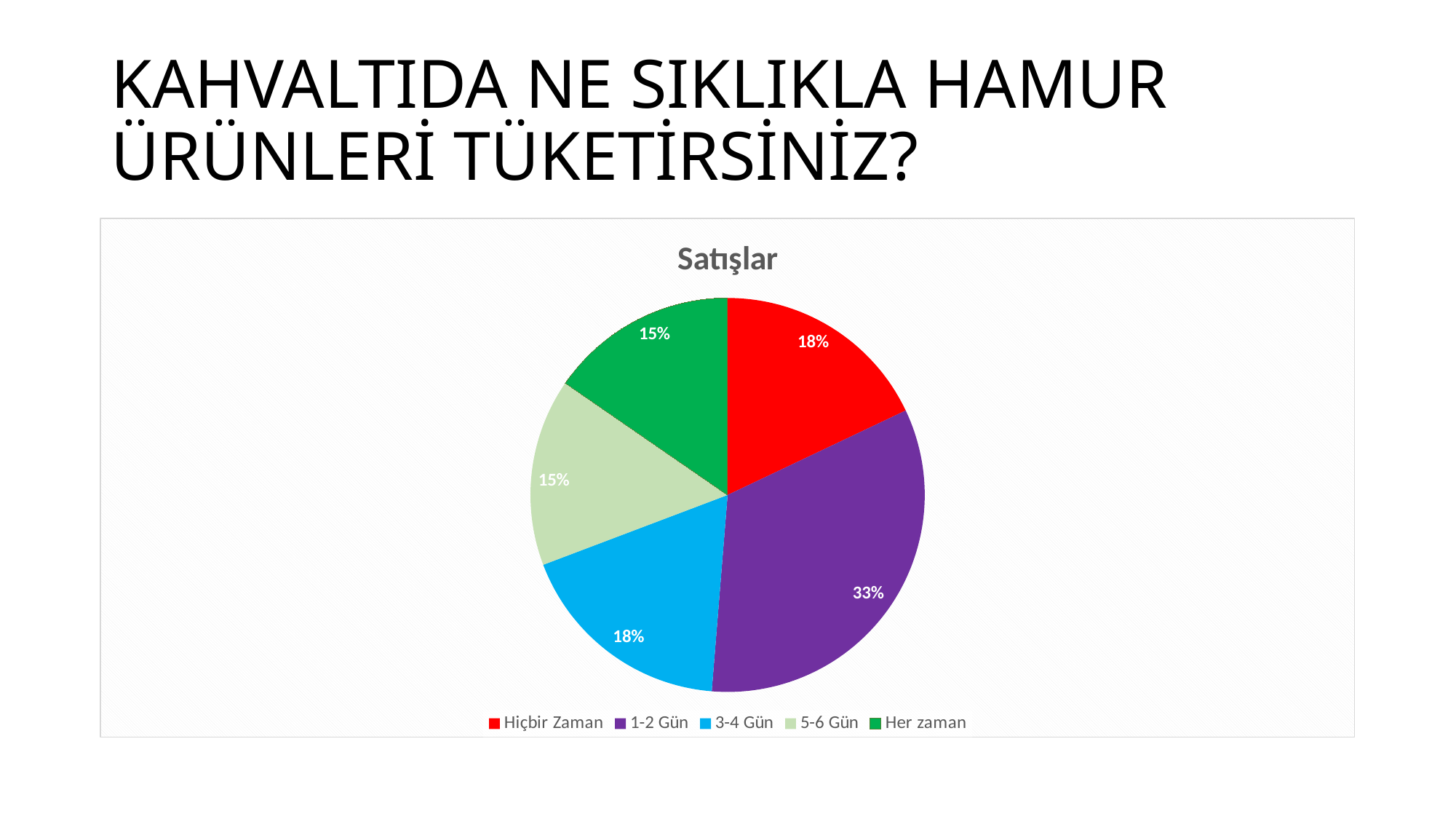
Which category has the largest slice of the pie? 1-2 Gün How many slices does the pie chart have? 5 What is the difference between the 1-2 Gün slice and the Hiçbir Zaman slice? 15% What colour is the 1-2 Gün slice in the pie chart? purple What kind of chart is shown on the slide? pie chart Which is larger, the 1-2 Gün slice or the 5-6 Gün slice? 1-2 Gün What is the value shown for Hiçbir Zaman? 18% What is the value shown for Her zaman? 15% What percentage of the pie does the 1-2 Gün slice represent? 33% What is the value shown for 3-4 Gün? 18% What is the title of the chart? Satışlar What is the value shown for 5-6 Gün? 15%